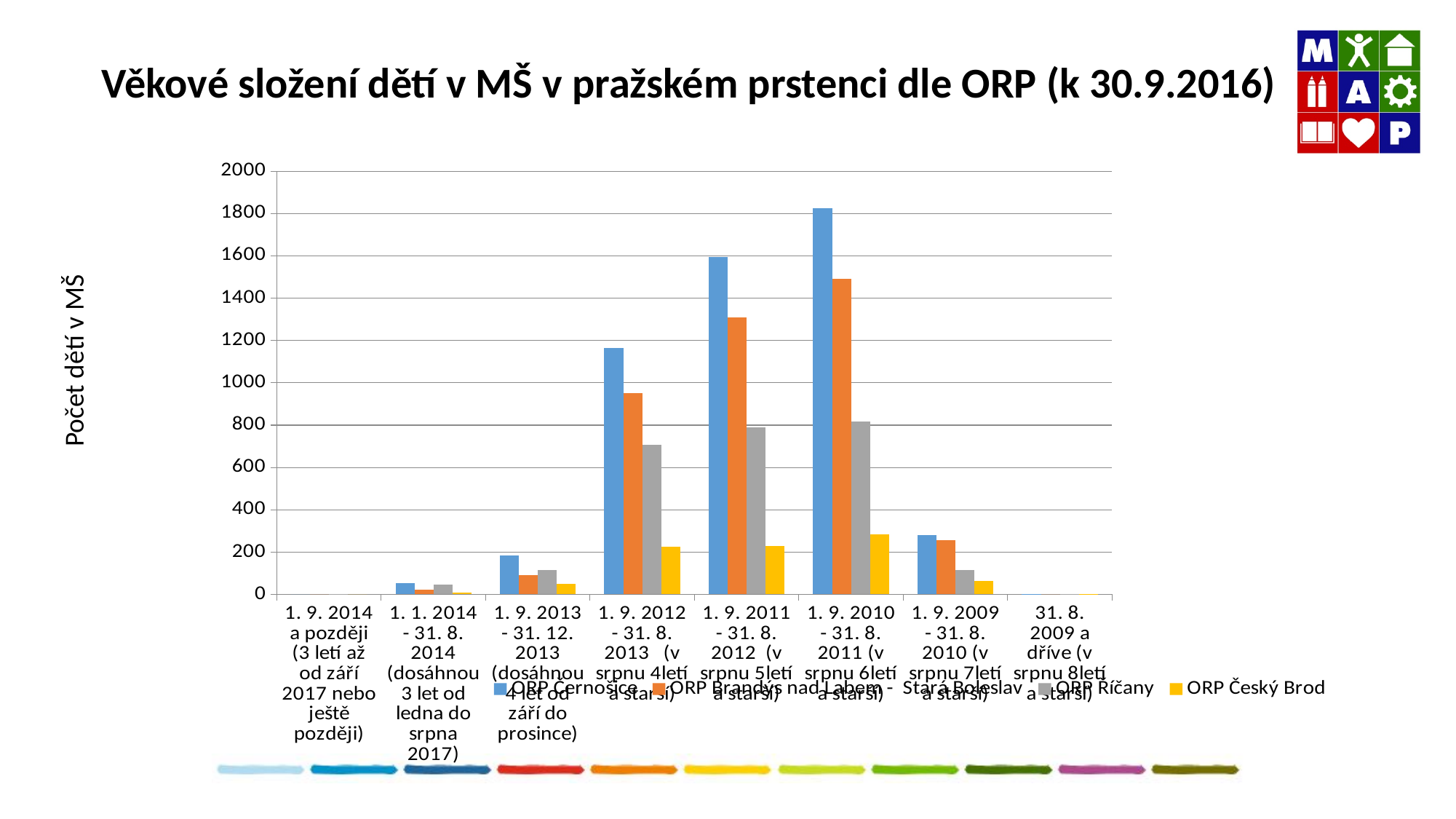
What kind of chart is shown on the slide? bar chart What is the title of the vertical axis? Počet dětí v MŠ How many series does the legend list? 4 How many age-group categories are shown on the x axis? 8 Is the value for ORP Brandýs nad Labem - Stará Boleslav in the category "1. 9. 2010 - 31. 8. 2011" greater or less than 1600? less Is the value for ORP Český Brod in the category "1. 9. 2010 - 31. 8. 2011" greater or less than 200? greater Is the value for ORP Černošice in the category "1. 9. 2010 - 31. 8. 2011" greater or less than 1600? greater In which category does ORP Černošice reach its highest value? 1. 9. 2010 - 31. 8. 2011 In the category "1. 9. 2011 - 31. 8. 2012", which is larger: ORP Říčany or ORP Český Brod? ORP Říčany Which series has the lowest bar in the category "1. 9. 2012 - 31. 8. 2013"? ORP Český Brod Which series has the highest bar in the category "1. 9. 2010 - 31. 8. 2011"? ORP Černošice